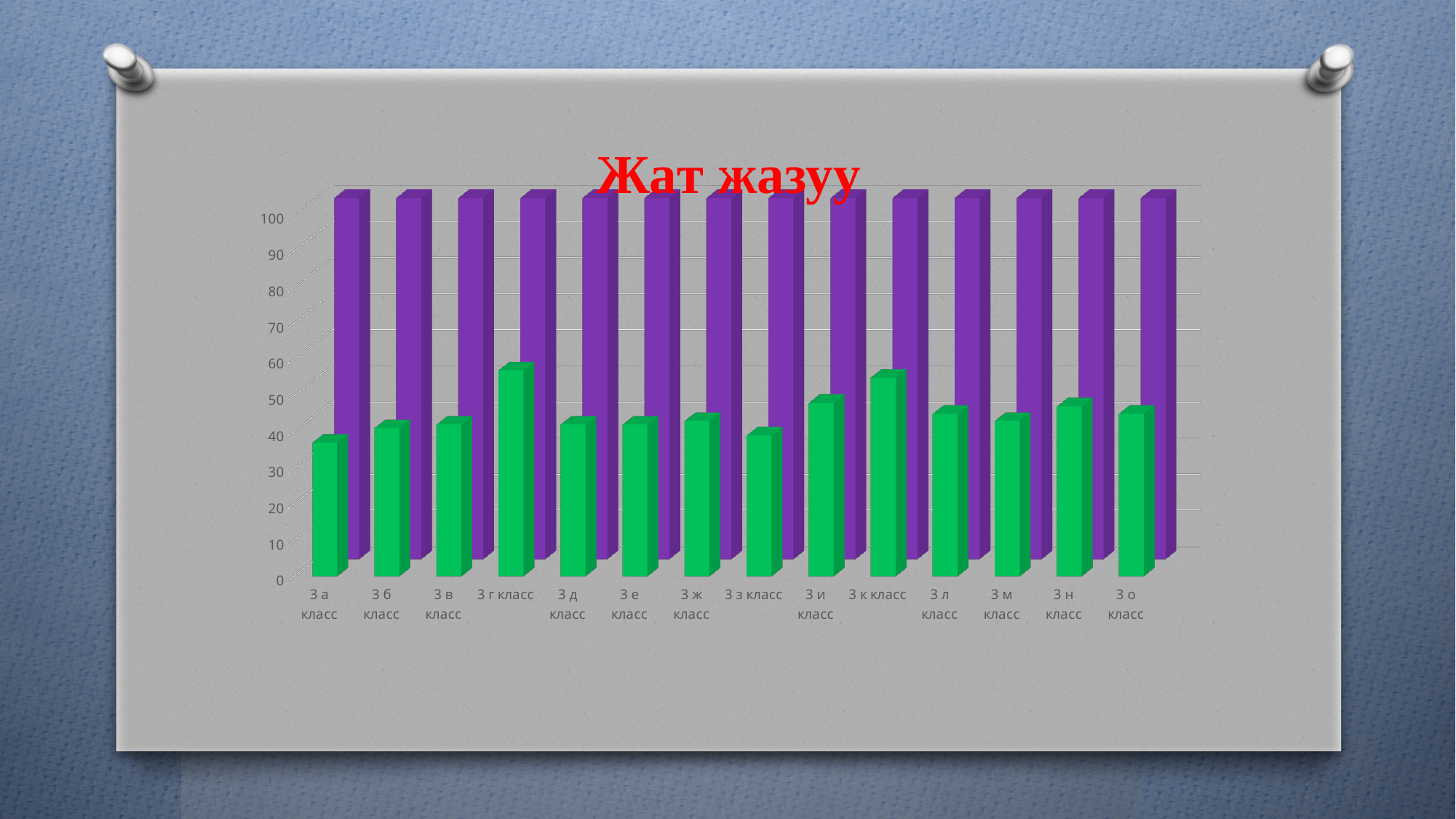
How many classes (categories) are shown on the x axis? 14 Is the green bar for 3 з класс greater or less than 50? less What kind of chart is shown on the slide? bar chart What is the title of the chart? Жат жазуу What two colours are used for the bars in the chart? purple and green Is the purple bar for 3 а класс greater or less than 90? greater Is the green bar for 3 к класс greater or less than 50? greater How many bars are plotted for each class? 2 Which has the taller green bar, 3 г класс or 3 а класс? 3 г класс For 3 б класс, which bar is taller, the purple one or the green one? the purple one